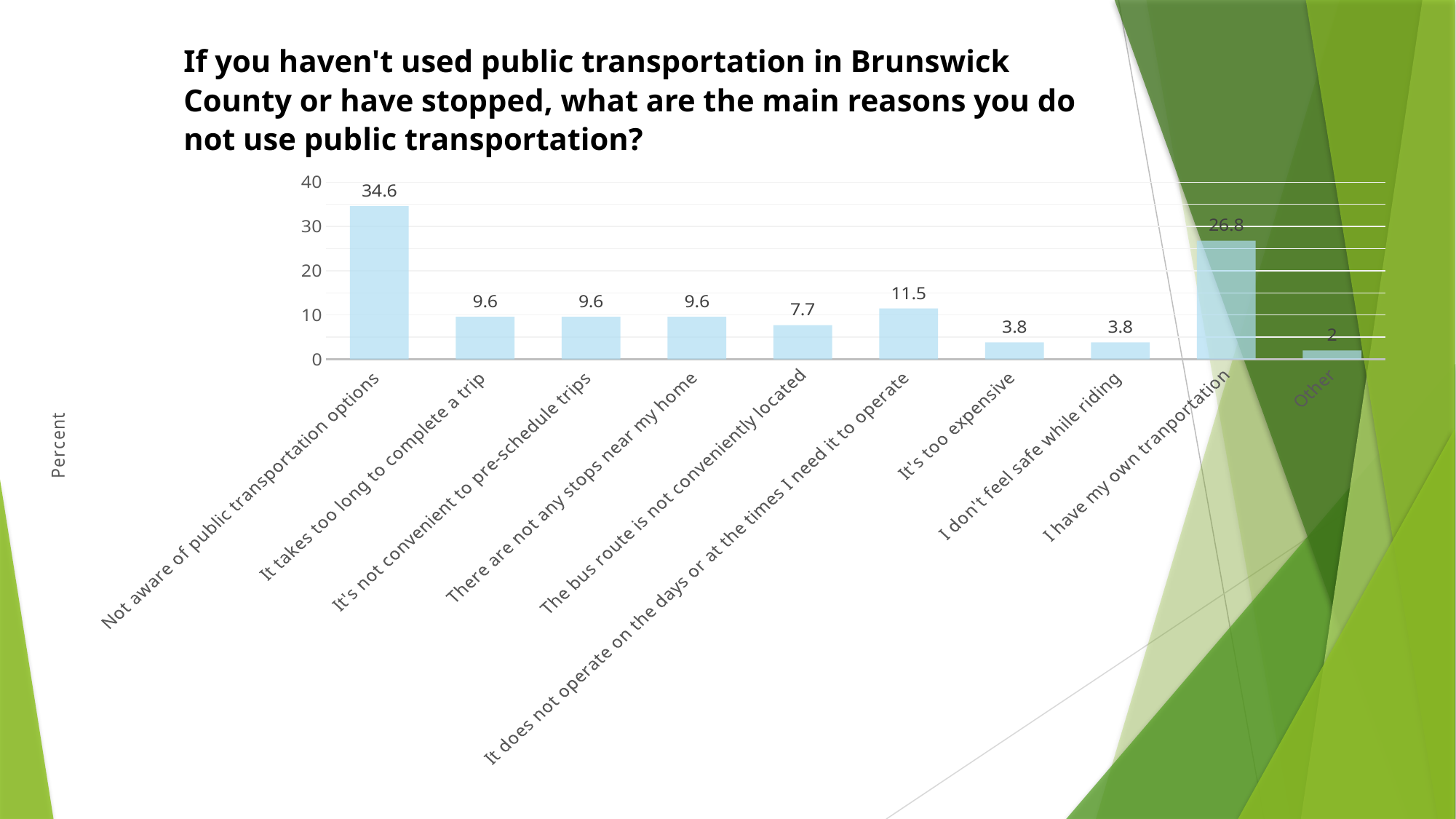
What is the value for "It's too expensive"? 3.8 What is the value for "I have my own tranportation"? 26.8 Which is larger: the value for "It does not operate on the days or at the times I need it to operate" or the value for "It takes too long to complete a trip"? It does not operate on the days or at the times I need it to operate What is the value for "The bus route is not conveniently located"? 7.7 What is the difference between the values for "Not aware of public transportation options" and "I have my own tranportation"? 7.8 What kind of chart is shown on the slide? bar chart What is the label of the vertical axis? Percent Which category has the highest value? Not aware of public transportation options Is the value for "I have my own tranportation" greater or less than 20? greater Which category has the lowest value? Other What is the value for "Not aware of public transportation options"? 34.6 How many categories are shown on the x axis? 10